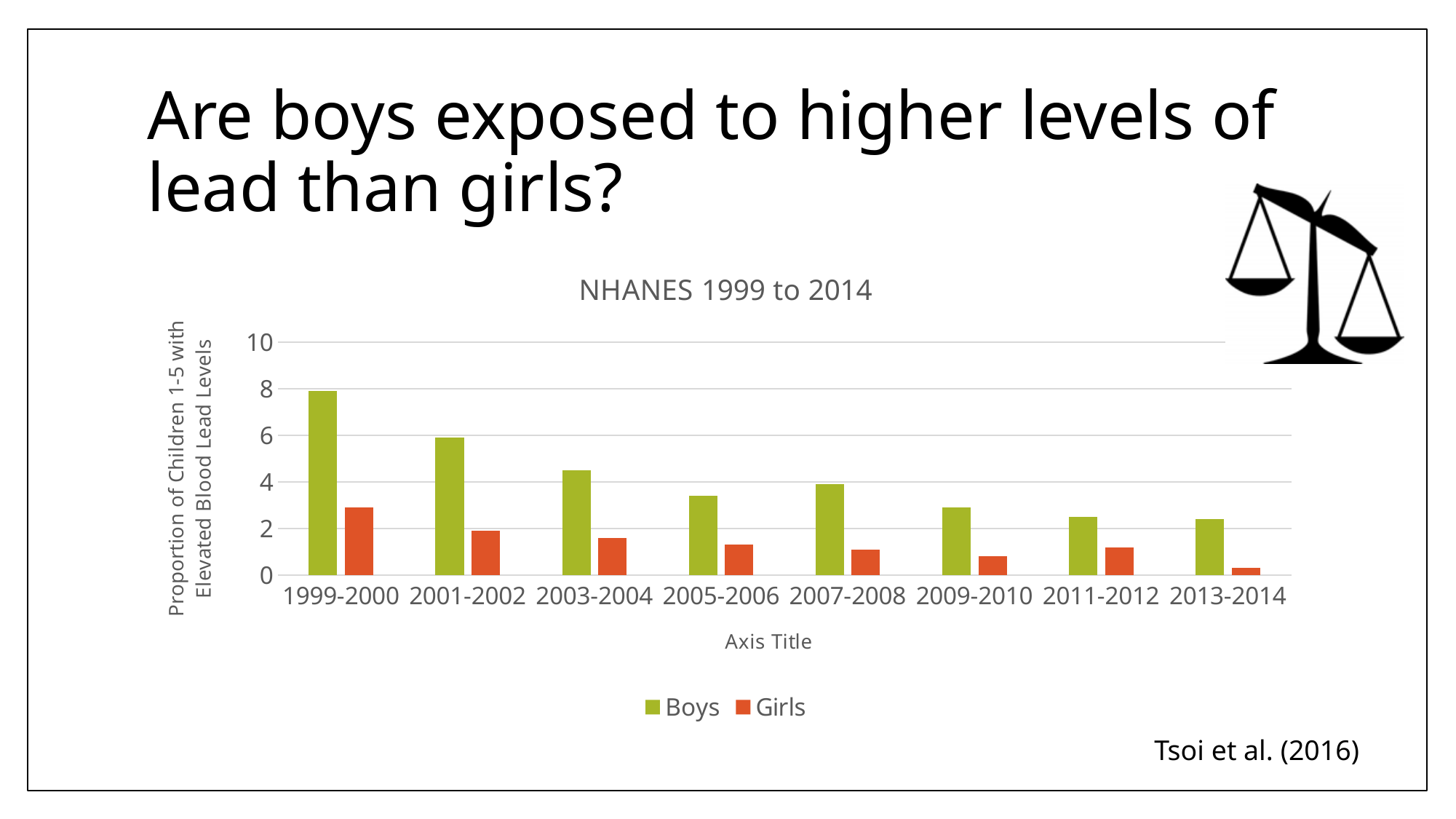
How many series does the legend list? 2 Do the values for Boys generally rise or fall from 1999-2000 to 2013-2014? fall Is the value for Boys in 1999-2000 greater or less than 6? greater How many survey periods are shown on the x axis? 8 Is the value for Girls in 1999-2000 greater or less than 2? greater What kind of chart is shown on the slide? bar chart Is the value for Boys in 2005-2006 greater or less than 4? less In which survey period is the value for Boys highest? 1999-2000 In which survey period is the value for Girls highest? 1999-2000 In which survey period is the value for Girls lowest? 2013-2014 Which is larger in 2007-2008, the value for Boys or the value for Girls? Boys What is the title of the chart? NHANES 1999 to 2014